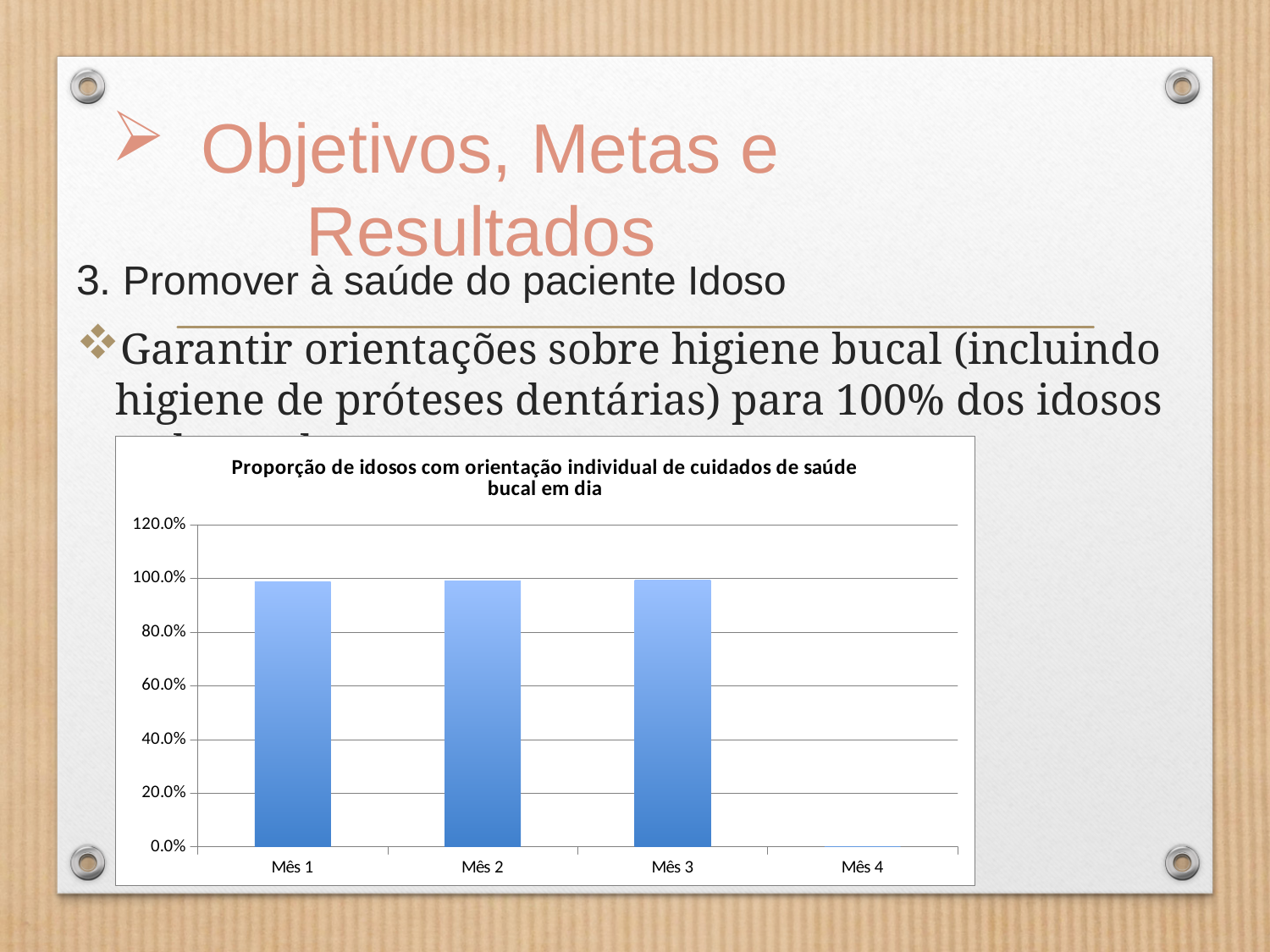
How many categories (months) are shown on the x axis of the chart? 4 What is the highest tick value shown on the y axis of the chart? 120.0% Does the value rise or fall from Mês 3 to Mês 4? fall Is the value for Mês 1 greater or less than 80.0%? greater Which month has the lowest value in the chart? Mês 4 What kind of chart is shown on the slide? bar chart Is the value for Mês 4 greater or less than 20.0%? less Which is larger, the value for Mês 2 or the value for Mês 4? Mês 2 What is the title of the chart? Proporção de idosos com orientação individual de cuidados de saúde bucal em dia